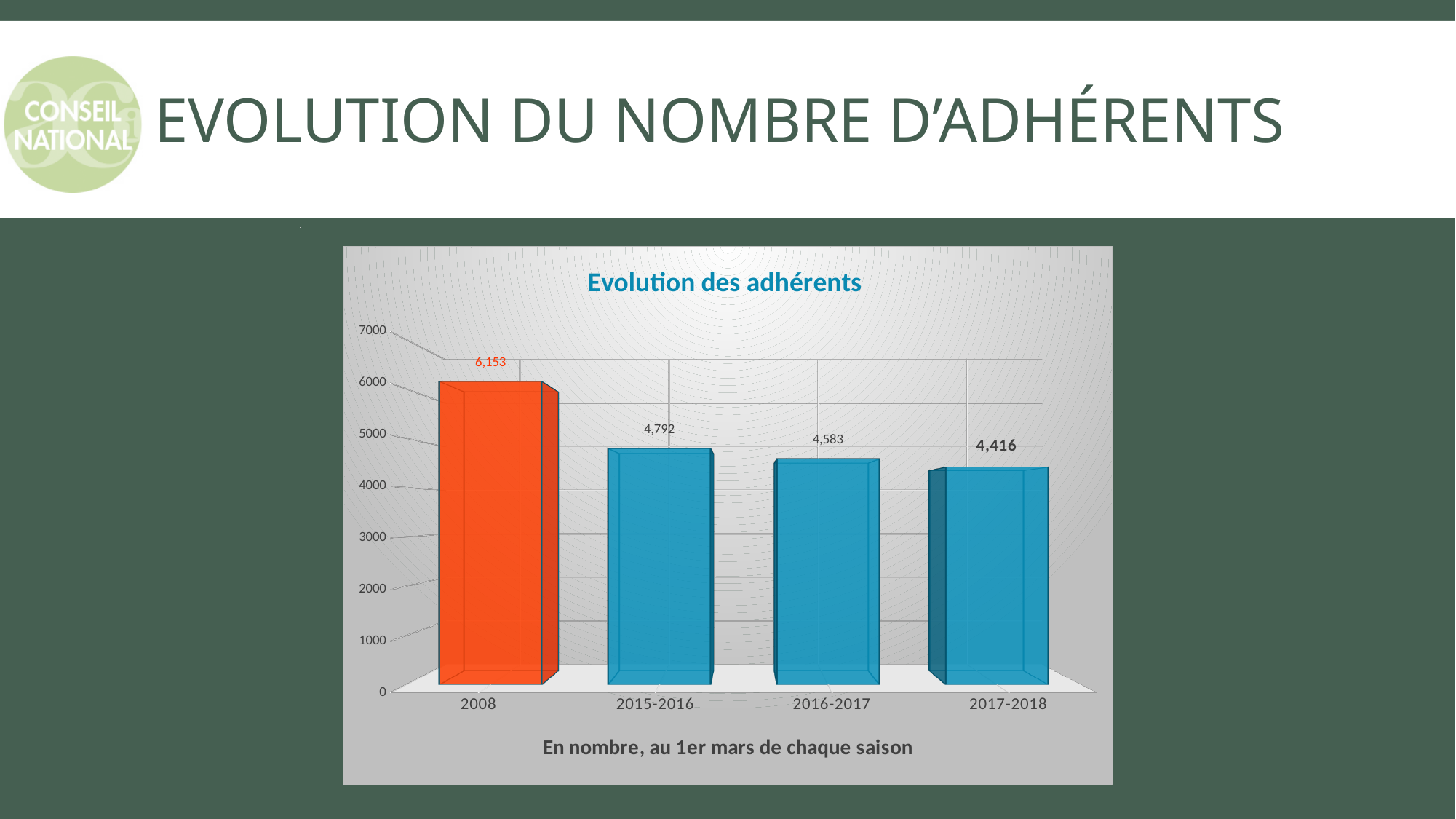
How many categories are shown on the x axis? 4 Do the values rise or fall from left to right along the x axis? Fall What is the difference between the values for 2008 and 2017-2018? 1,737 What is the value for 2017-2018? 4,416 What is the difference between the values for 2015-2016 and 2016-2017? 209 Which is larger, the value for 2015-2016 or the value for 2017-2018? 2015-2016 What is the value for 2008? 6,153 Which category has the lowest value? 2017-2018 What is the value for 2016-2017? 4,583 What kind of chart is shown? Bar chart Which category has the highest value? 2008 What is the value for 2015-2016? 4,792